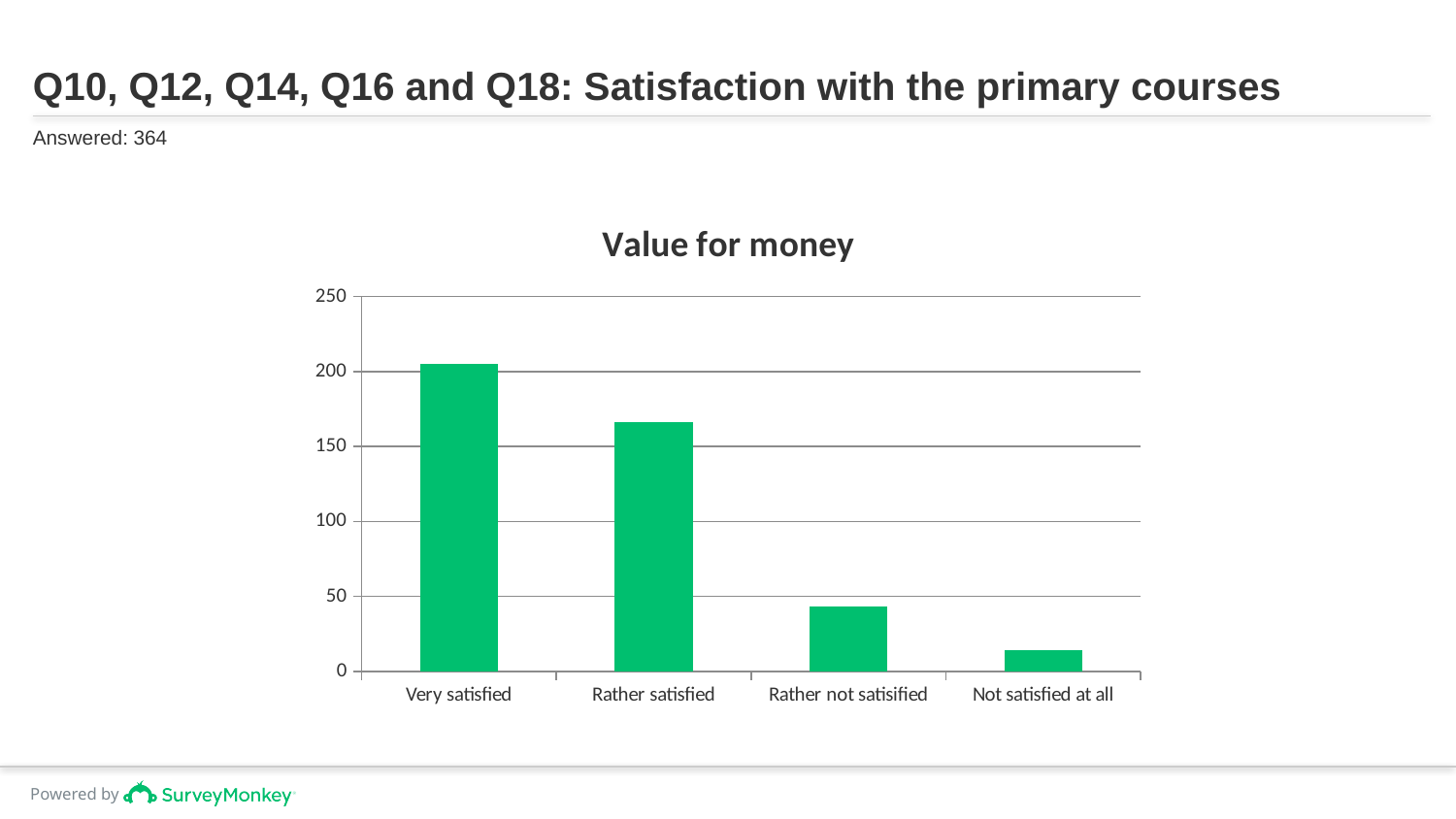
What kind of chart is shown on the slide? bar chart Is the value for Rather satisfied greater or less than 150? greater Is the value for Not satisfied at all greater or less than 50? less Which is larger, the value for Rather satisfied or the value for Rather not satisified? Rather satisfied Is the value for Very satisfied greater or less than 200? greater Do the values rise or fall moving from left to right along the x axis? fall What is the title of the chart? Value for money Which category has the highest value? Very satisfied How many categories are shown on the x axis of the chart? 4 What is the highest value shown on the vertical axis? 250 Which category has the lowest value? Not satisfied at all